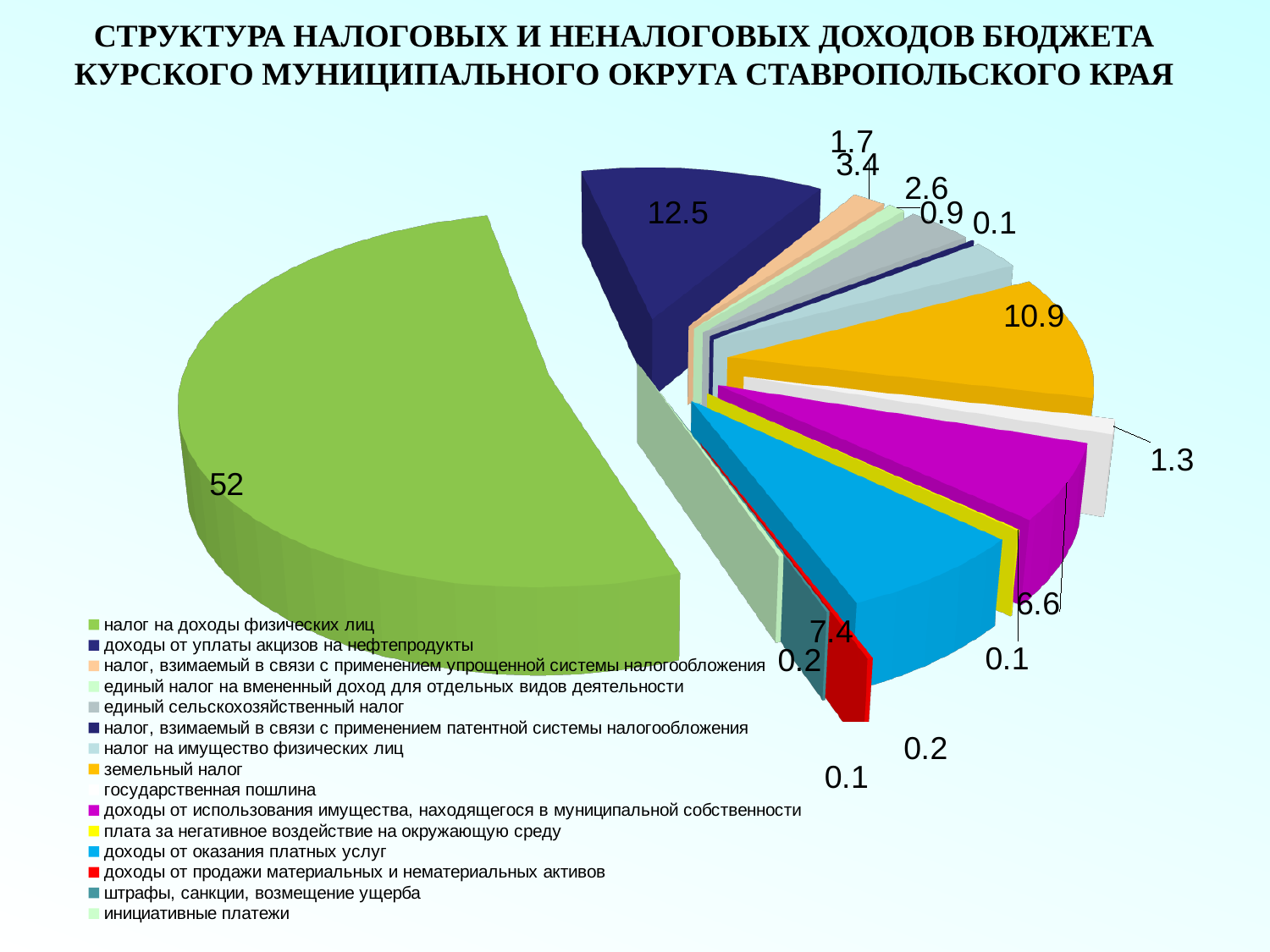
What is the value shown for доходы от оказания платных услуг? 7.4 What is the value shown for налог на доходы физических лиц? 52 What colour is the slice for налог на доходы физических лиц? green Which category has the largest slice in the pie chart? налог на доходы физических лиц What is the value shown for государственная пошлина? 1.3 What is the value shown for доходы от использования имущества, находящегося в муниципальной собственности? 6.6 What is the value shown for доходы от уплаты акцизов на нефтепродукты? 12.5 What type of chart is shown on the slide? pie chart What is the value shown for земельный налог? 10.9 How many categories does the legend of the pie chart list? 15 Which is larger: доходы от уплаты акцизов на нефтепродукты or земельный налог? доходы от уплаты акцизов на нефтепродукты What is the difference between the values for налог на доходы физических лиц and доходы от уплаты акцизов на нефтепродукты? 39.5